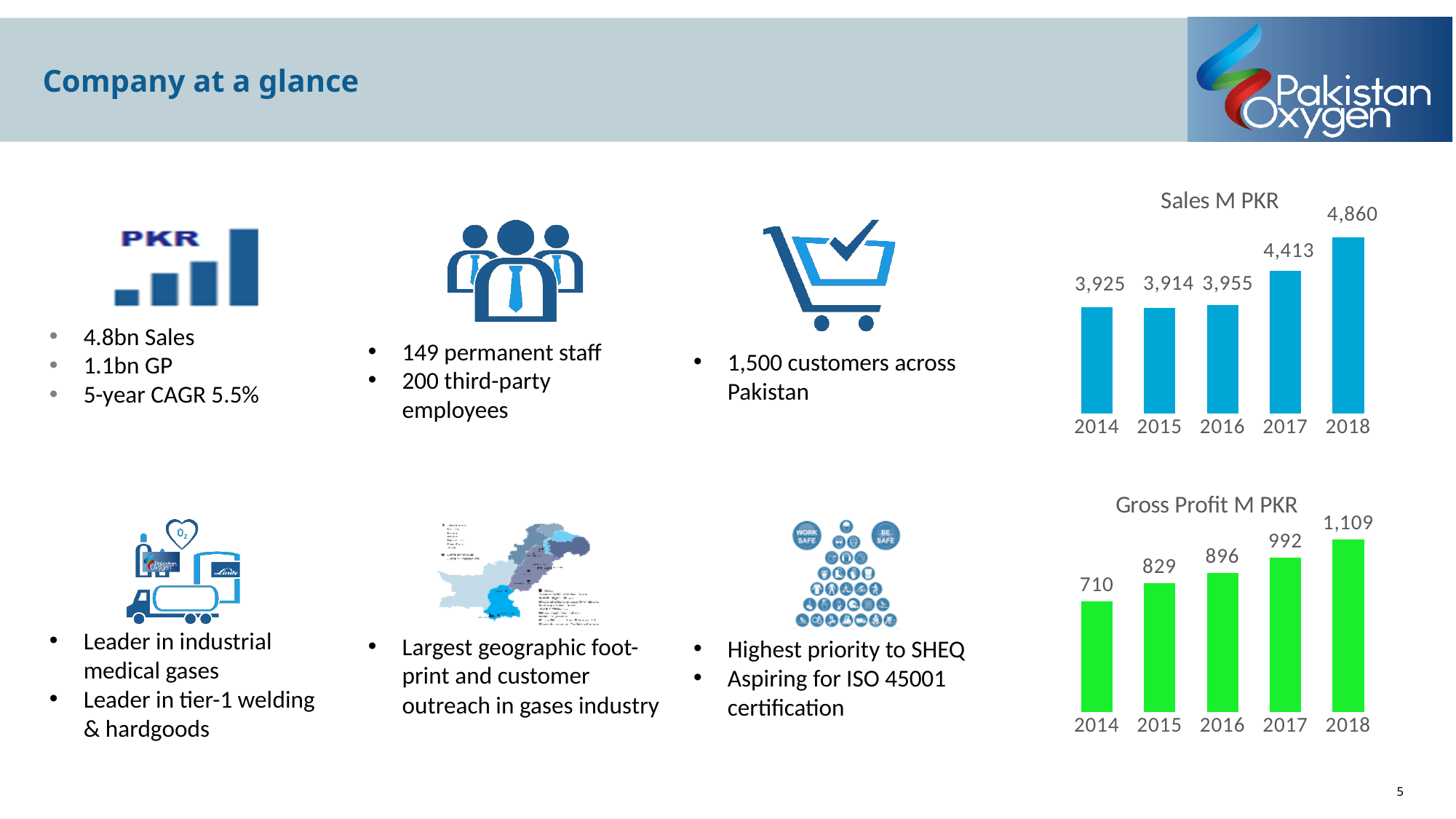
What kind of chart is the Gross Profit M PKR chart? bar chart In the Gross Profit M PKR chart, which year has the highest gross profit? 2018 In the Gross Profit M PKR chart, what is the value for 2014? 710 In the Sales M PKR chart, how many years are shown? 5 In the Gross Profit M PKR chart, what is the difference between the 2016 and 2015 values? 67 In the Sales M PKR chart, what is the value for 2018? 4,860 In the Sales M PKR chart, what is the difference between the 2018 and 2017 values? 447 In the Sales M PKR chart, which is larger, the value for 2014 or the value for 2016? 2016 In the Sales M PKR chart, what is the value for 2015? 3,914 In the Gross Profit M PKR chart, do the values rise or fall from 2014 to 2018? rise In the Gross Profit M PKR chart, what is the value for 2017? 992 In the Sales M PKR chart, which year has the lowest sales? 2015